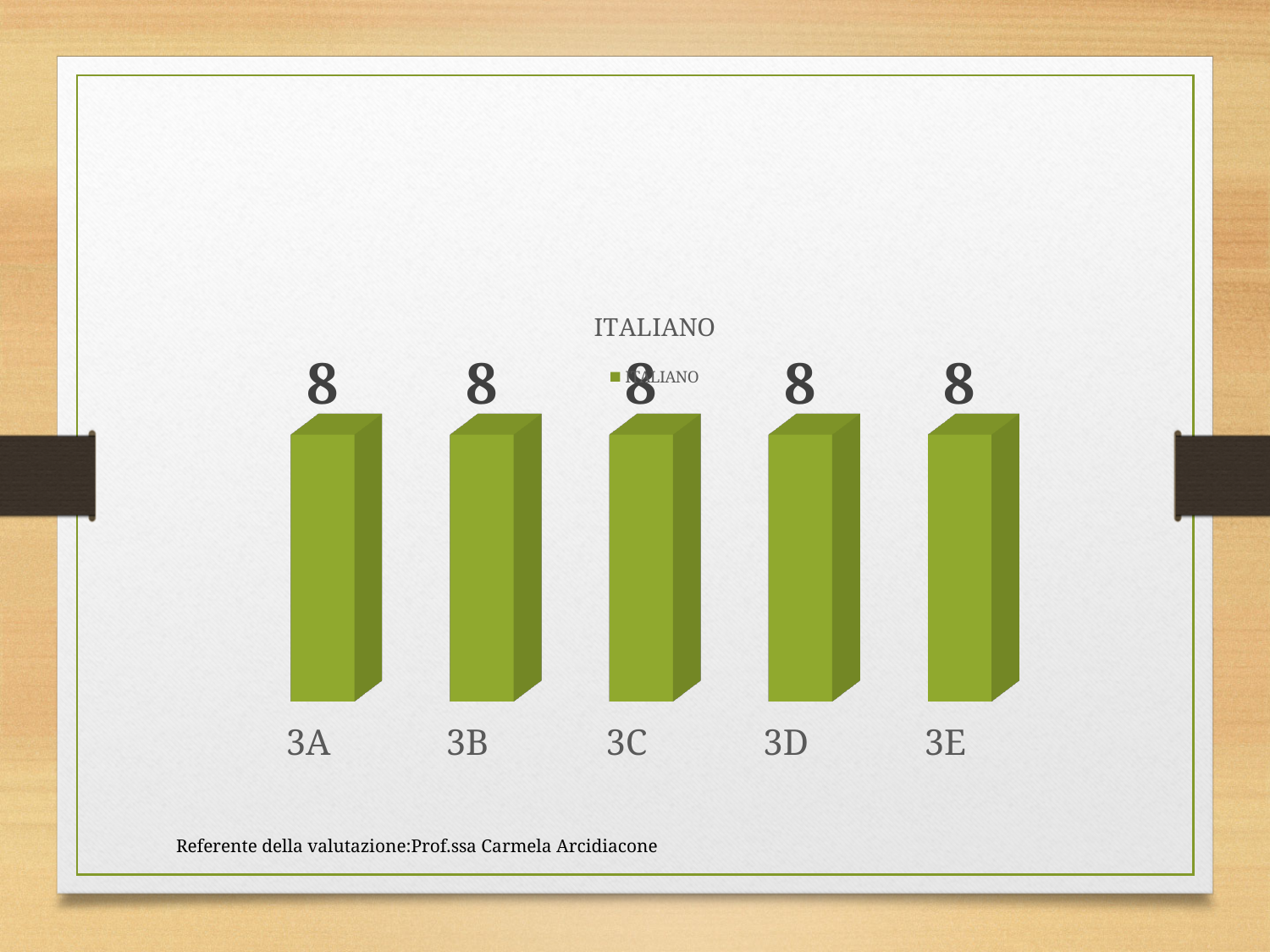
What is the value for 3C? 8 What is the difference between the values for 3A and 3E? 0 What is the title of the chart? ITALIANO What is the value for 3B? 8 What is the value for 3E? 8 Do the values rise, fall, or stay flat from 3A to 3E? stay flat What kind of chart is shown? bar chart How many categories are shown on the x axis? 5 What is the value for 3A? 8 What is the value for 3D? 8 How many series does the legend list? 1 What colour are the bars? green